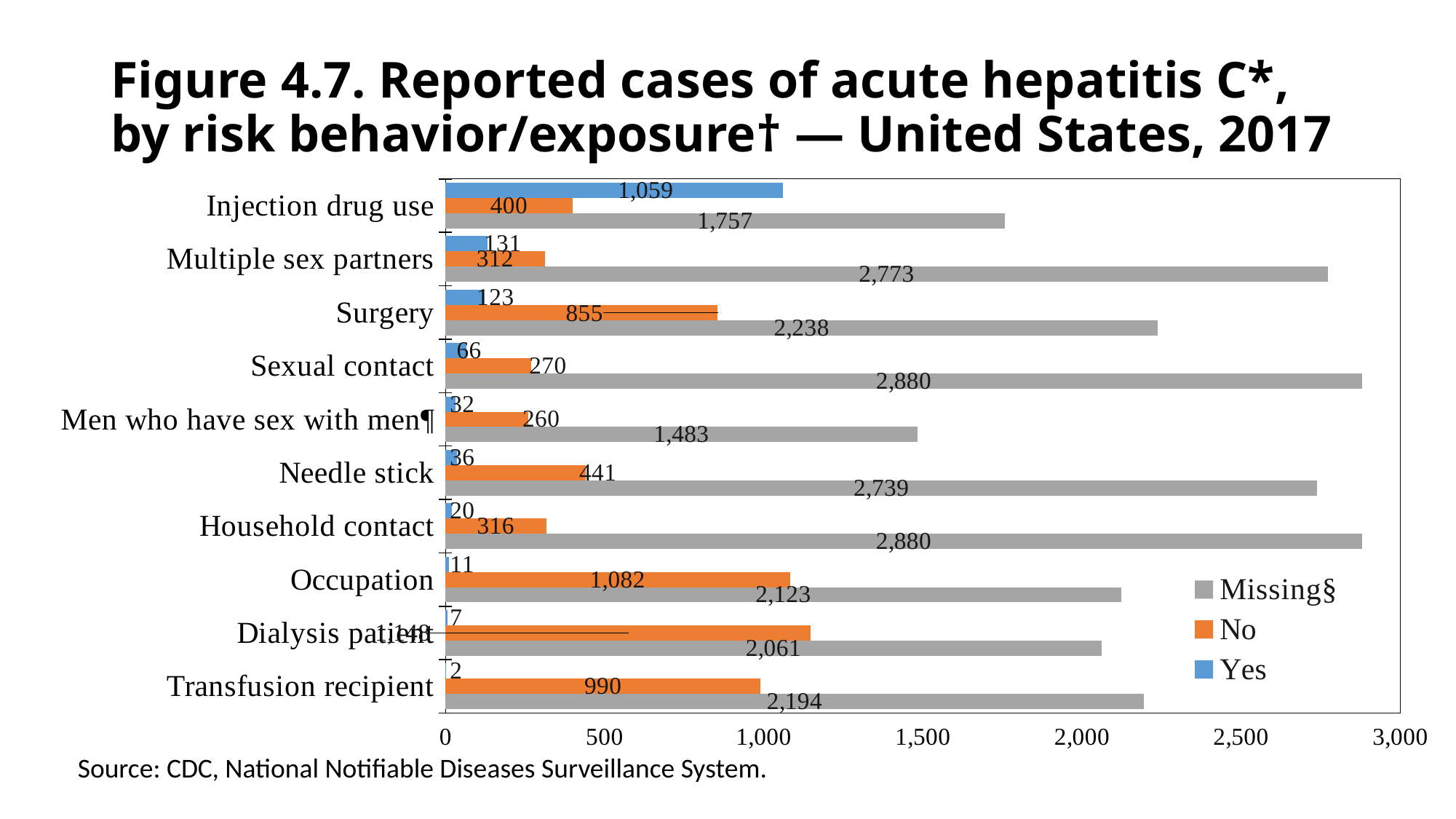
What is the 'Yes' value for Injection drug use? 1,059 For Injection drug use, what is the difference between the 'Missing' value and the 'Yes' value? 698 Which category has the lowest 'Yes' value? Transfusion recipient Is the 'Missing' value for Sexual contact greater or less than 2,500? greater How many risk behavior/exposure categories are plotted? 10 Which category has the highest 'Yes' value? Injection drug use Which series is shown in orange? No How many series does the legend list? 3 What kind of chart is shown on the slide? Bar chart Which is larger: the 'No' value for Occupation or the 'No' value for Surgery? Occupation What is the 'No' value for Needle stick? 441 What is the 'Missing' value for Multiple sex partners? 2,773